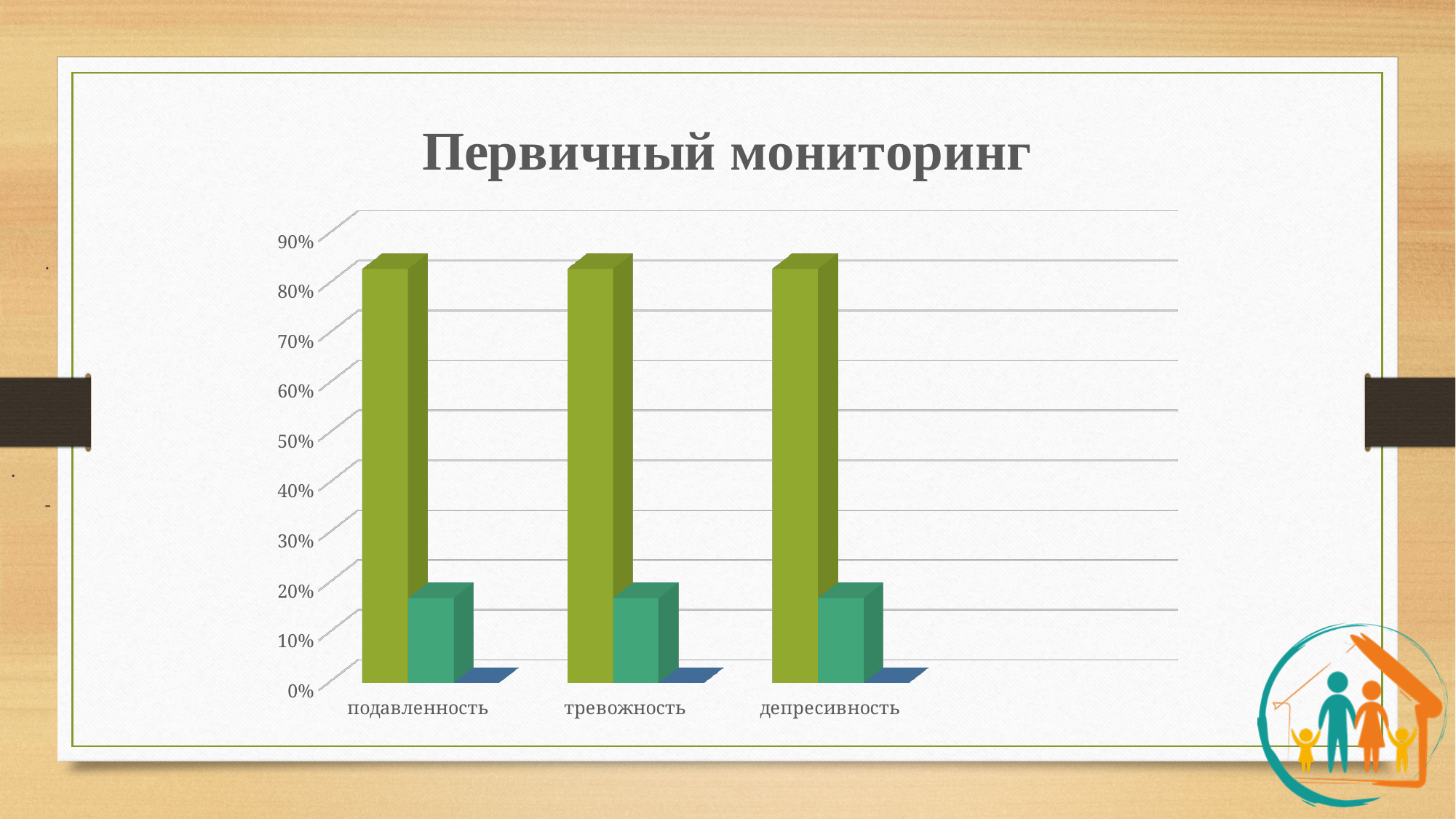
Is the value of the green bar for депресивность greater or less than 50%? greater Is the value of the tallest (green) bar for подавленность greater or less than 80%? greater What is the highest value labelled on the vertical axis? 90% Is the value of the teal bar for депресивность greater or less than 20%? less What is the title of the chart? Первичный мониторинг For тревожность, which bar is larger: the green bar or the teal bar? the green bar Which category is listed first on the x axis? подавленность How many categories are shown on the x axis of the chart? 3 What kind of chart is shown on the slide? bar chart Do the green bars rise, fall, or stay roughly the same across the three categories? stay roughly the same